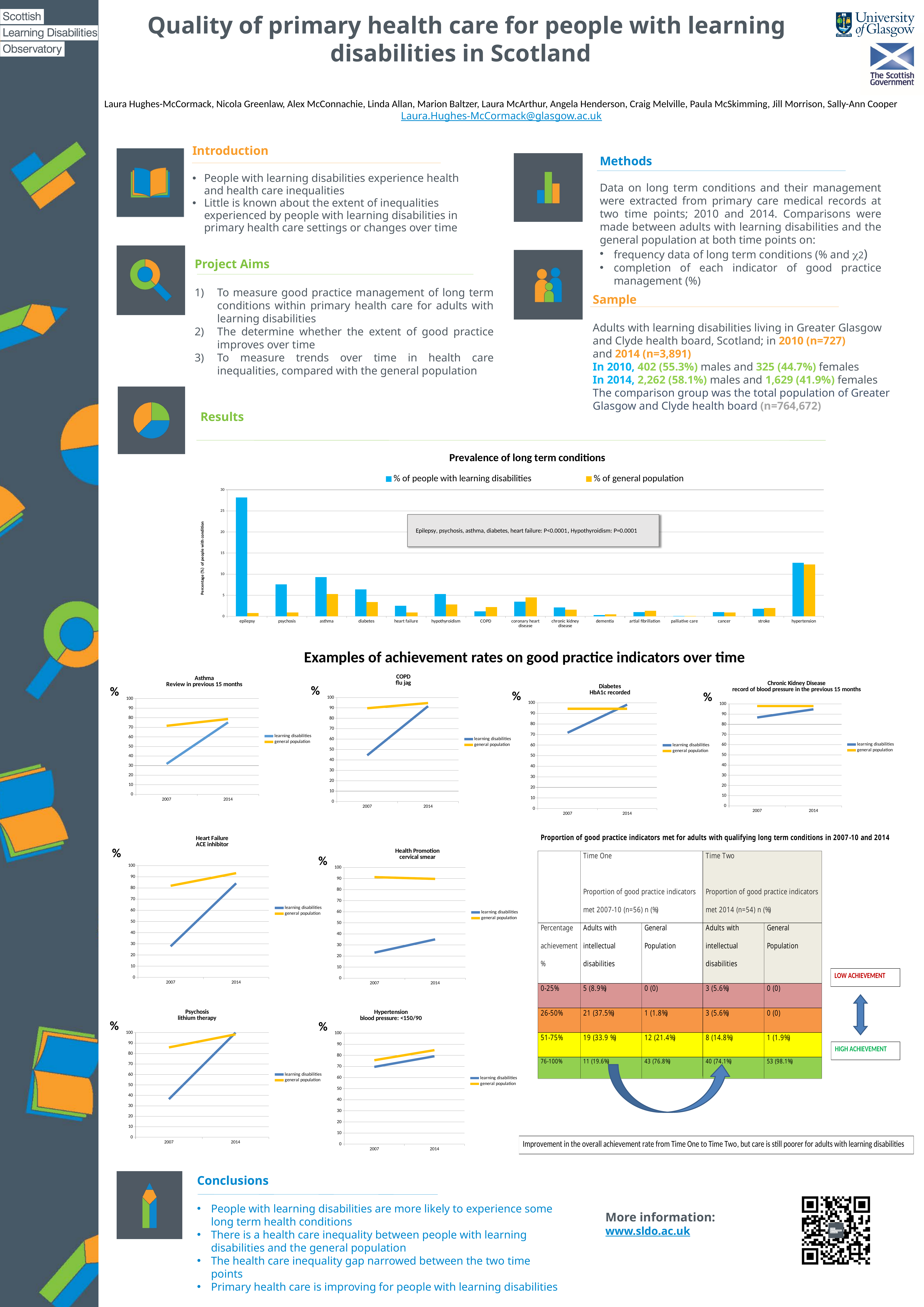
In the 'Prevalence of long term conditions' chart, which is larger for coronary heart disease: % of people with learning disabilities or % of general population? % of general population How many series does the legend of the 'Heart Failure ACE inhibitor' chart list? 2 In the 'Prevalence of long term conditions' chart, which is larger for epilepsy: % of people with learning disabilities or % of general population? % of people with learning disabilities In the 'Prevalence of long term conditions' chart, which condition has the highest value for % of people with learning disabilities? epilepsy In the 'Prevalence of long term conditions' chart, which series is shown in blue? % of people with learning disabilities In the 'Prevalence of long term conditions' chart, is the value for asthma among people with learning disabilities greater or less than 10? less What kind of chart is the 'Prevalence of long term conditions' chart? bar chart How many series does the legend of the 'Prevalence of long term conditions' chart list? 2 How many conditions are shown on the x axis of the 'Prevalence of long term conditions' chart? 15 In the 'Prevalence of long term conditions' chart, is the value for epilepsy among people with learning disabilities greater or less than 25? greater In the 'Asthma Review in previous 15 months' chart, does the learning disabilities line rise or fall from 2007 to 2014? rise In the 'COPD flu jag' chart, is the learning disabilities value for 2007 greater or less than 50? less